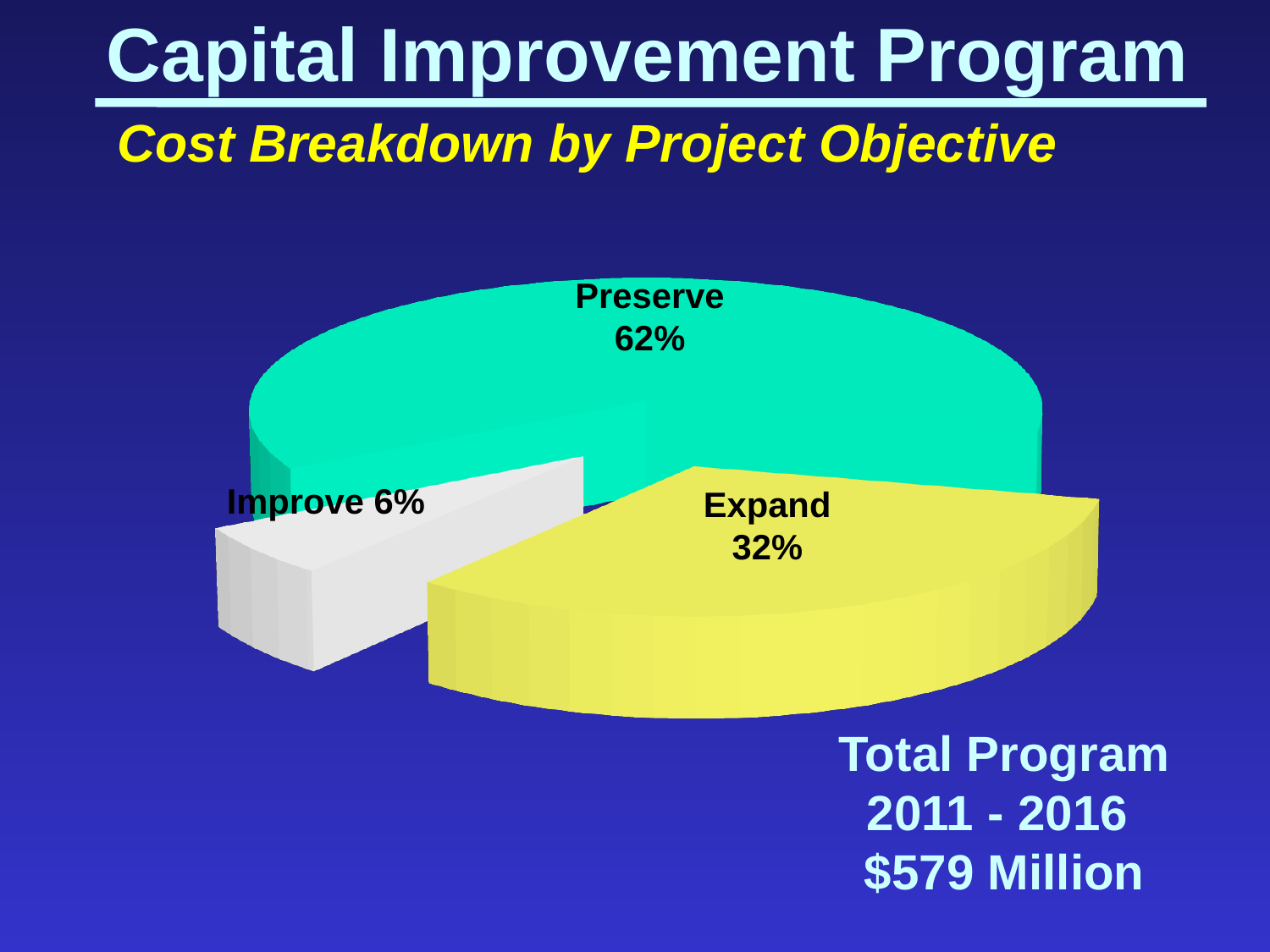
What is the subtitle of the chart on the slide? Cost Breakdown by Project Objective How many slices does the pie chart have? 3 Which is larger, the share for Expand or the share for Improve? Expand What share of the pie does Improve account for? 6% How many percentage points larger is the Expand share than the Improve share? 26 Which project objective has the smallest share of the cost breakdown? Improve What is the total program amount stated on the slide for 2011 - 2016? $579 Million What share of the pie does Expand account for? 32% Which project objective has the largest share of the cost breakdown? Preserve How many percentage points larger is the Preserve share than the Expand share? 30 What kind of chart is shown on the slide? Pie chart What share of the pie does Preserve account for? 62%